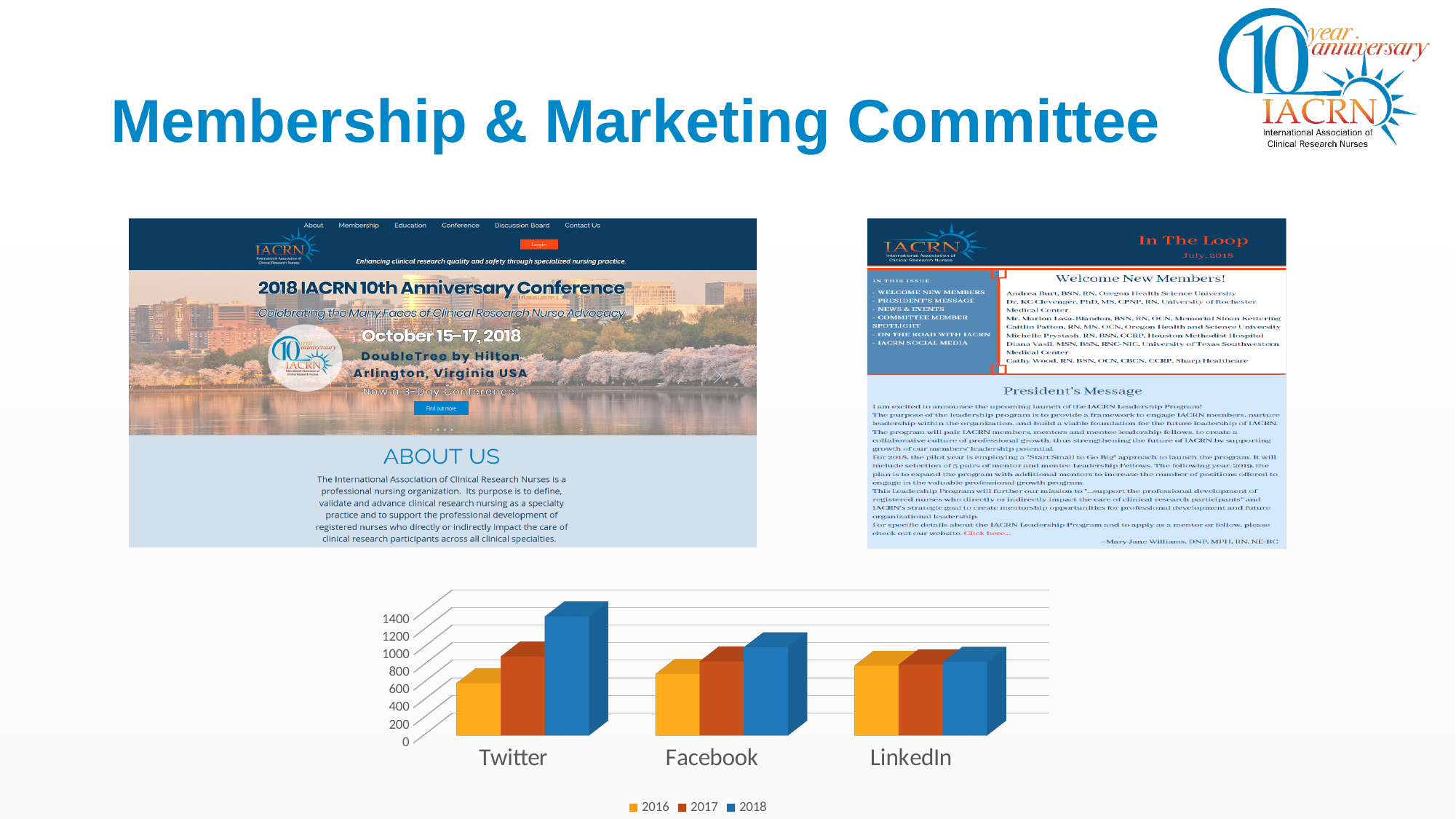
Which is larger for 2018: the value for Twitter or the value for Facebook? Twitter Is the 2016 value for Twitter greater or less than 800? less What kind of chart is shown at the bottom of the slide? bar chart Do the values for Twitter rise or fall from 2016 to 2018? rise For Twitter, which year has the highest bar? 2018 For Twitter, which year has the lowest bar? 2016 How many categories are shown on the x axis of the bar chart? 3 Which colour represents 2018 in the bar chart? blue Is the 2016 value for LinkedIn greater or less than 1000? less Which years are listed in the legend of the bar chart? 2016, 2017, 2018 How many series does the legend of the bar chart list? 3 Is the 2018 value for Twitter greater or less than 1000? greater